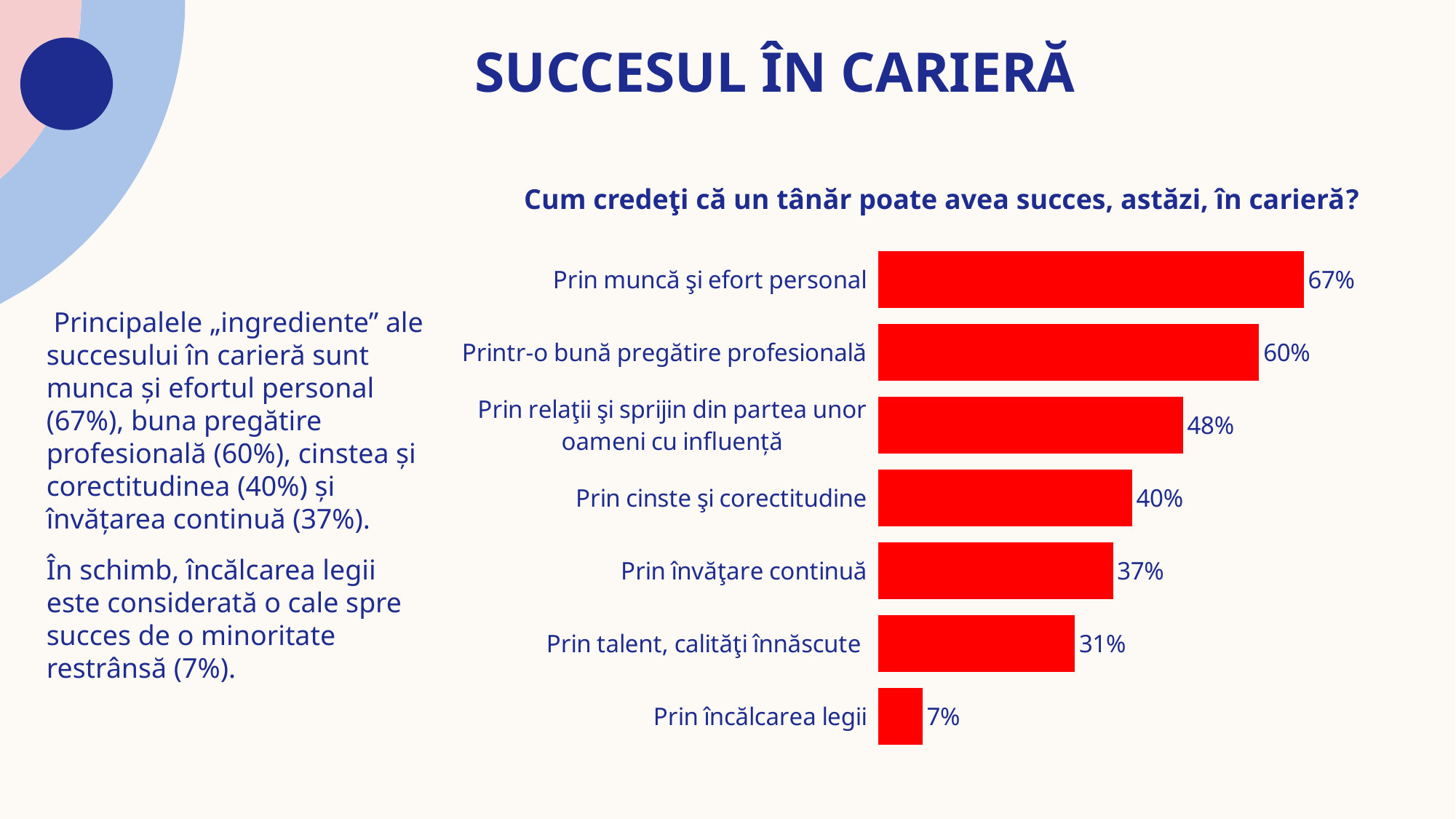
What is the value for "Prin cinste şi corectitudine"? 40% What is the value for "Prin muncă şi efort personal"? 67% What kind of chart is shown on the slide? Bar chart Which category has the lowest value? Prin încălcarea legii What is the title of the chart? Cum credeţi că un tânăr poate avea succes, astăzi, în carieră? Which is larger, the value for "Prin învăţare continuă" or the value for "Prin talent, calităţi înnăscute"? Prin învăţare continuă What is the difference between the values for "Prin muncă şi efort personal" and "Printr-o bună pregătire profesională"? 7% Which category has the highest value? Prin muncă şi efort personal What is the value for "Prin relaţii şi sprijin din partea unor oameni cu influență"? 48% How many categories are shown in the chart? 7 What is the difference between the values for "Prin cinste şi corectitudine" and "Prin încălcarea legii"? 33% What is the value for "Prin talent, calităţi înnăscute"? 31%